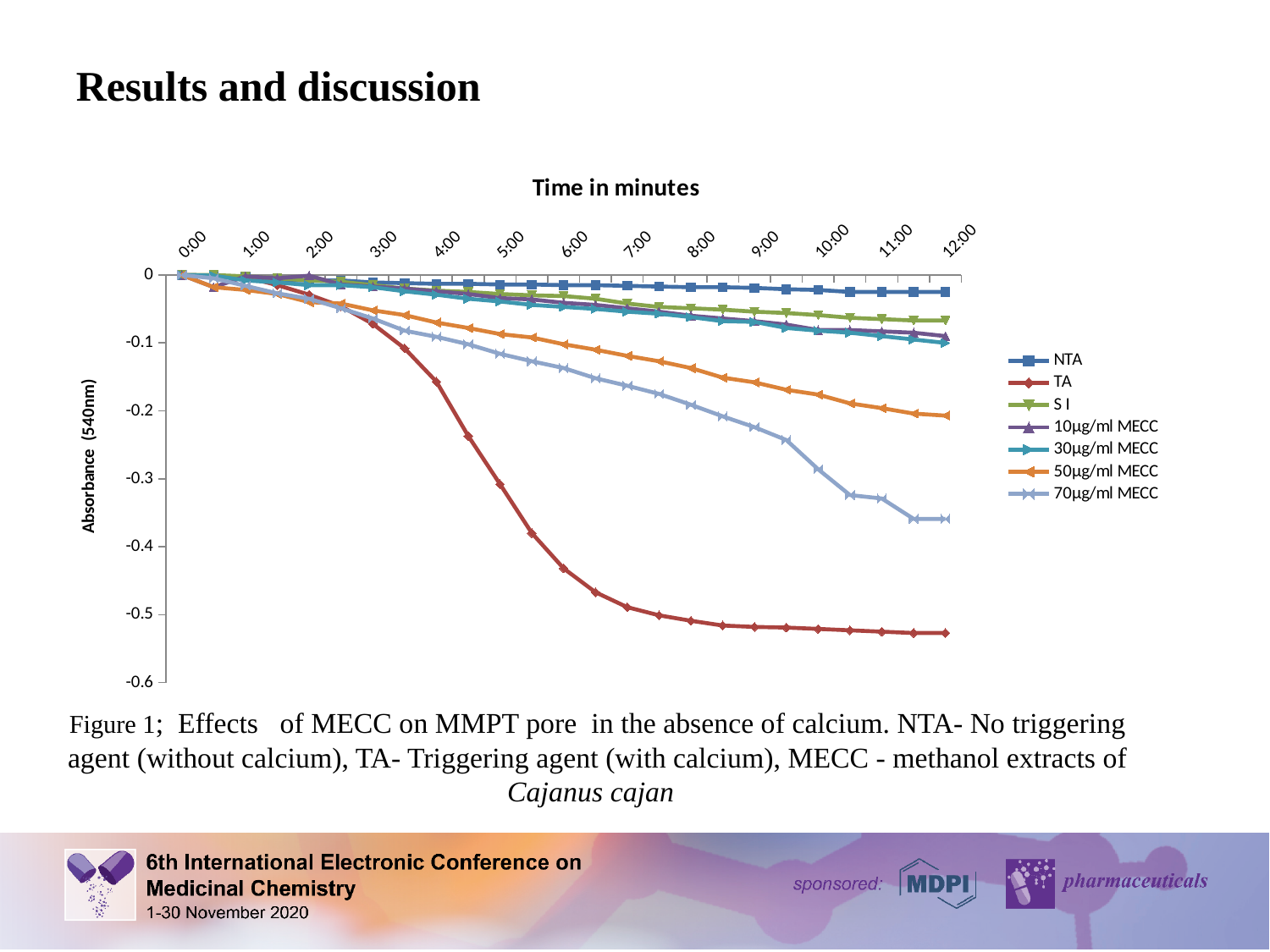
Is the value for TA at 12:00 greater or less than -0.5? less What kind of chart is shown on the slide? line chart Is the value for NTA at 12:00 greater or less than -0.1? greater What is the title of the vertical axis? Absorbance (540nm) What is the title shown above the chart? Time in minutes Is the value for 70µg/ml MECC at 12:00 greater or less than -0.3? less How many series does the legend list? 7 How many time labels are shown along the x axis? 13 Which series stays closest to 0 across the whole time range? NTA Which series reaches the lowest absorbance value on the chart? TA At 12:00, which series has the higher absorbance value, TA or 50µg/ml MECC? 50µg/ml MECC Do the values for the TA series rise or fall as time increases along the x axis? fall